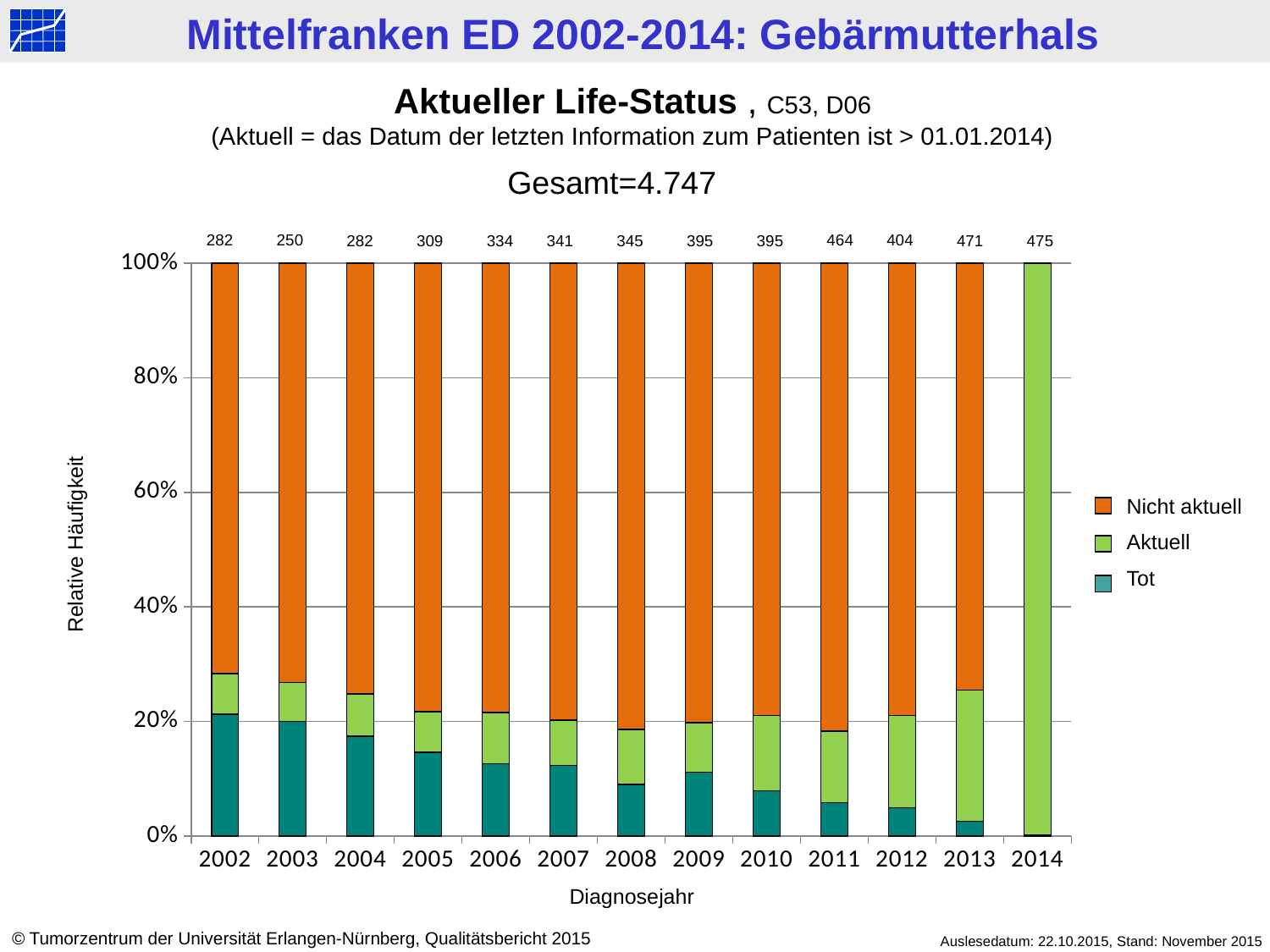
How many diagnosis years are shown on the x axis? 13 What is the number printed above the bar for 2011? 464 What is the difference between the numbers printed above the bars for 2014 and 2003? 225 Is the 'Nicht aktuell' share for 2002 greater or less than 60%? greater How many series does the legend list? 3 Is the 'Tot' share for 2013 greater or less than 20%? less Does the 'Tot' share rise or fall from 2002 to 2014? fall Which year has the highest number printed above its bar? 2014 Which year has the larger number printed above its bar, 2011 or 2012? 2011 What kind of chart is shown on the slide? stacked bar chart What is the number printed above the bar for 2002? 282 Which year has the lowest number printed above its bar? 2003